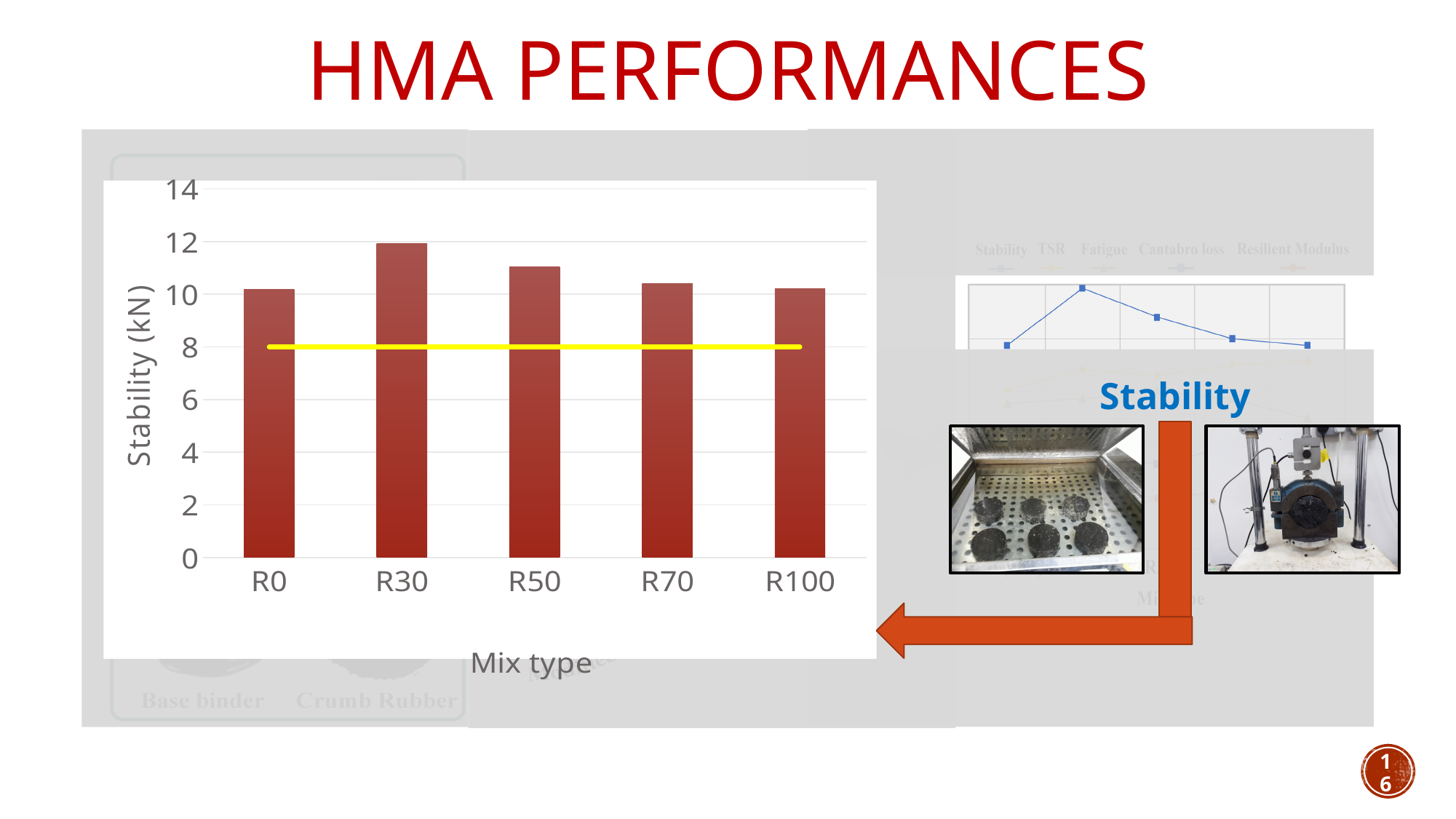
Is the stability value for R100 greater or less than 8? greater Is the stability value for R30 greater or less than 10? greater Is the stability value for R70 greater or less than 12? less Which has the higher stability, R30 or R50? R30 Do the stability values rise or fall from R30 to R100? fall Which mix type has the highest stability in the bar chart? R30 What kind of chart is shown on the slide? bar chart Which has the higher stability, R50 or R70? R50 How many mix types are shown on the x axis of the bar chart? 5 What is the title of the x axis of the bar chart? Mix type What is the title of the y axis of the bar chart? Stability (kN)